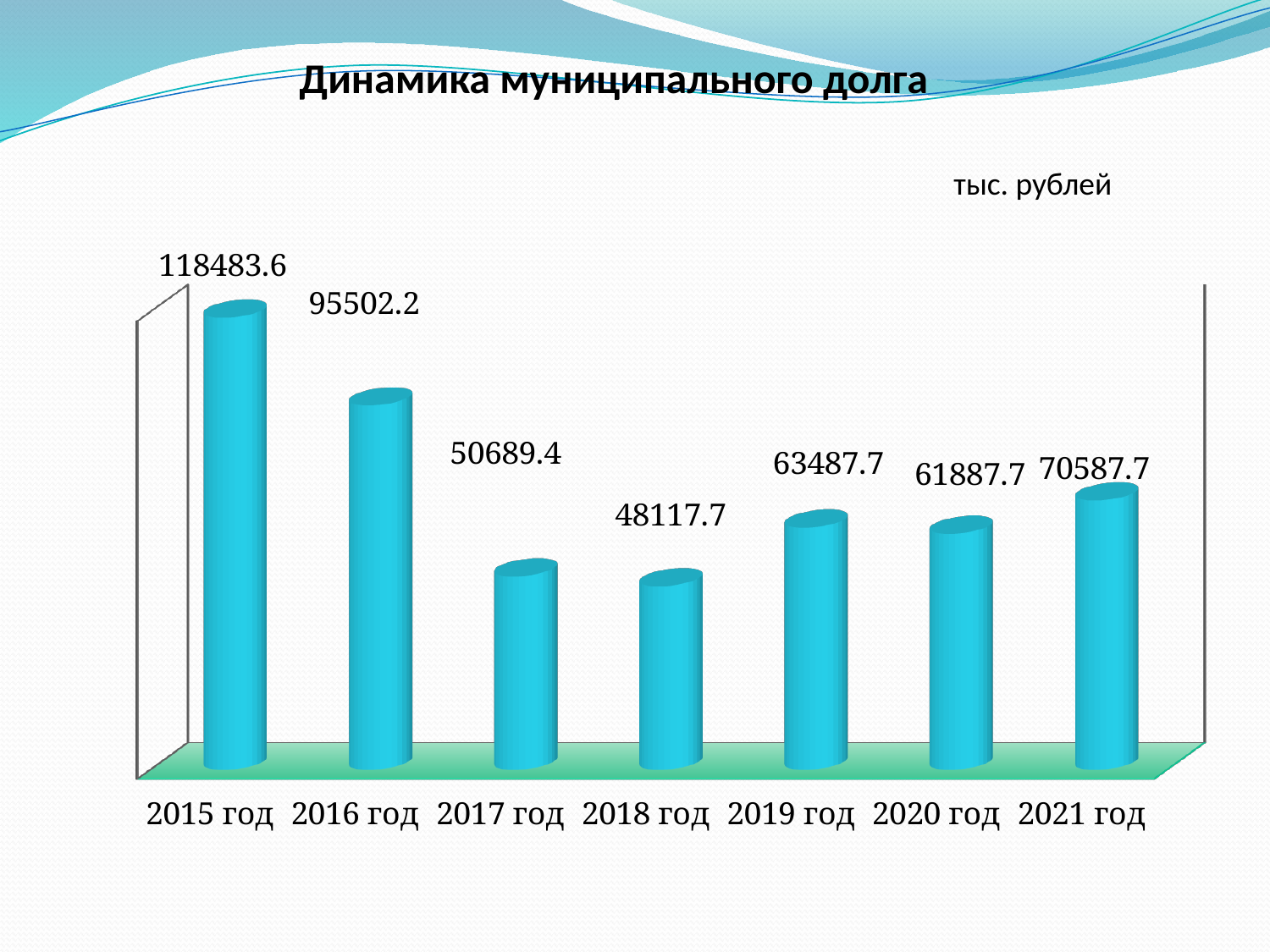
What is the value for 2021 год? 70587.7 What is the difference between the values for 2021 год and 2020 год? 8700 What is the value for 2018 год? 48117.7 What is the difference between the values for 2015 год and 2016 год? 22981.4 How many years are shown on the chart? 7 What kind of chart is shown on the slide? bar chart Which year has the highest value? 2015 год What is the value for 2015 год? 118483.6 Which year has the lowest value? 2018 год What is the title of the chart? Динамика муниципального долга Which is larger, the value for 2019 год or the value for 2020 год? 2019 год Do the values rise or fall from 2015 год to 2018 год? fall